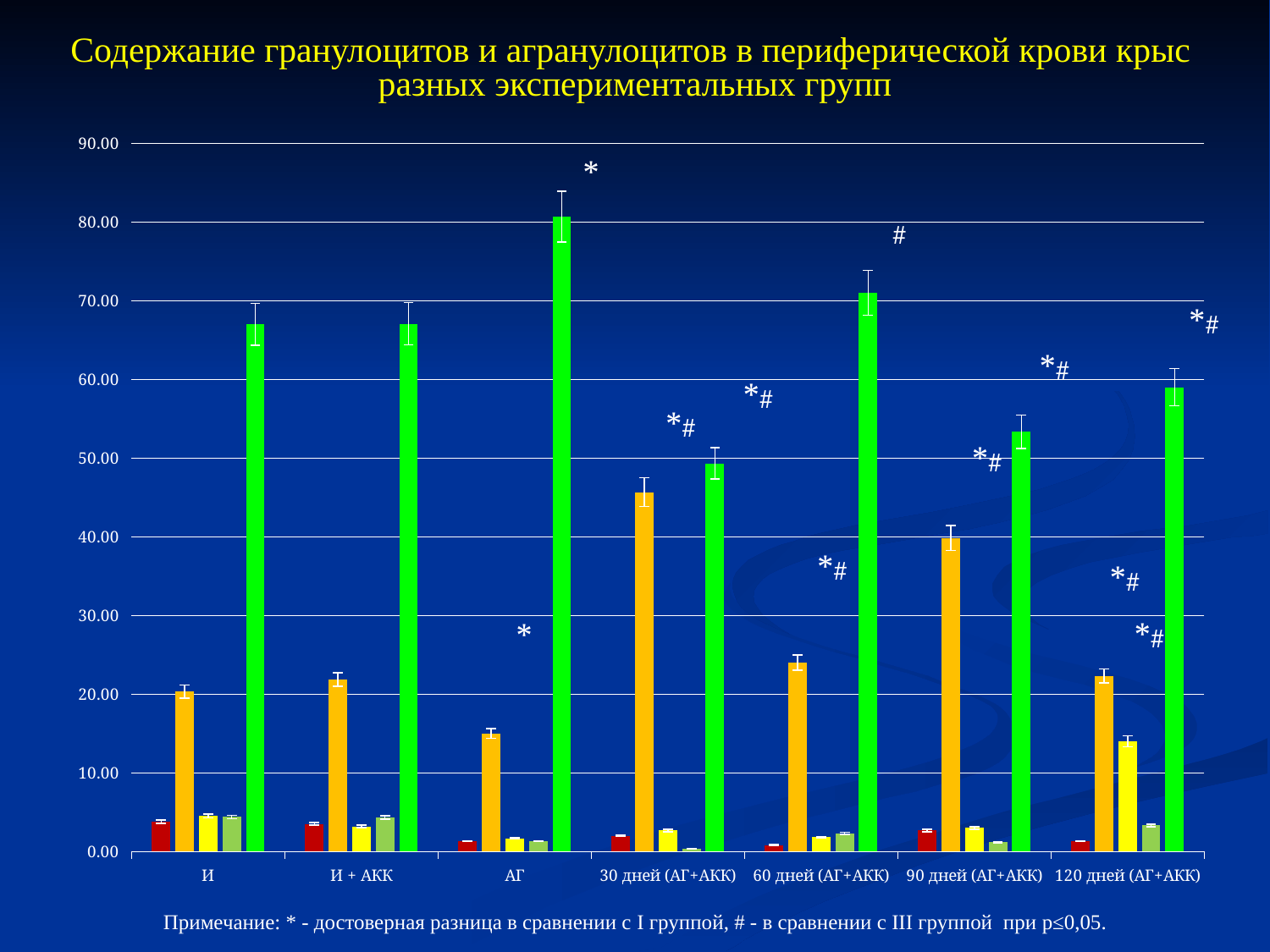
For which category is the orange bar the highest? 30 дней (АГ+АКК) For which category is the tallest bright green bar? АГ Is the bright green bar for АГ greater or less than 70.00? greater Is the bright green bar for 30 дней (АГ+АКК) greater or less than 60.00? less What kind of chart is shown on the slide? bar chart Is the orange bar for 90 дней (АГ+АКК) greater or less than 30.00? greater How many bars are plotted for each category? 5 Which has the taller bright green bar: АГ or И? АГ How many categories are shown along the x axis? 7 For which category is the bright green bar the lowest? 30 дней (АГ+АКК) What is the highest value shown on the y axis? 90.00 For which category is the orange bar the lowest? АГ